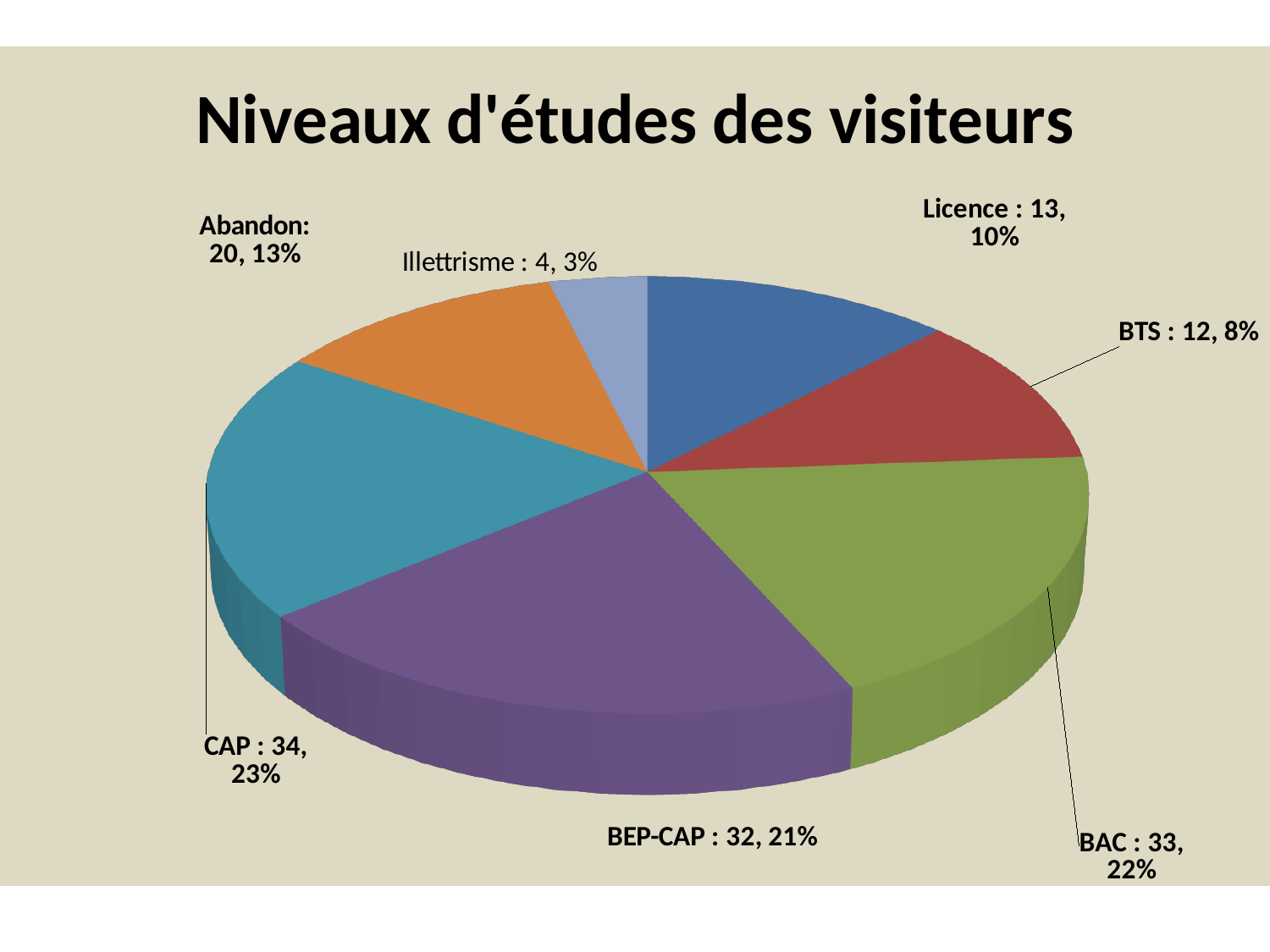
What percentage share does BAC have? 22% What is the value for CAP? 34 Which category has the smallest value? Illettrisme Which category has the largest value? CAP What is the title of the chart? Niveaux d'études des visiteurs What is the difference between the values for CAP and BTS? 22 What is the total of all the slice values in the pie chart? 148 What percentage share does Illettrisme have? 3% Which is larger, the value for Abandon or the value for Licence? Abandon How many slices does the pie chart have? 7 What type of chart is shown on the slide? pie chart What is the value for Licence? 13